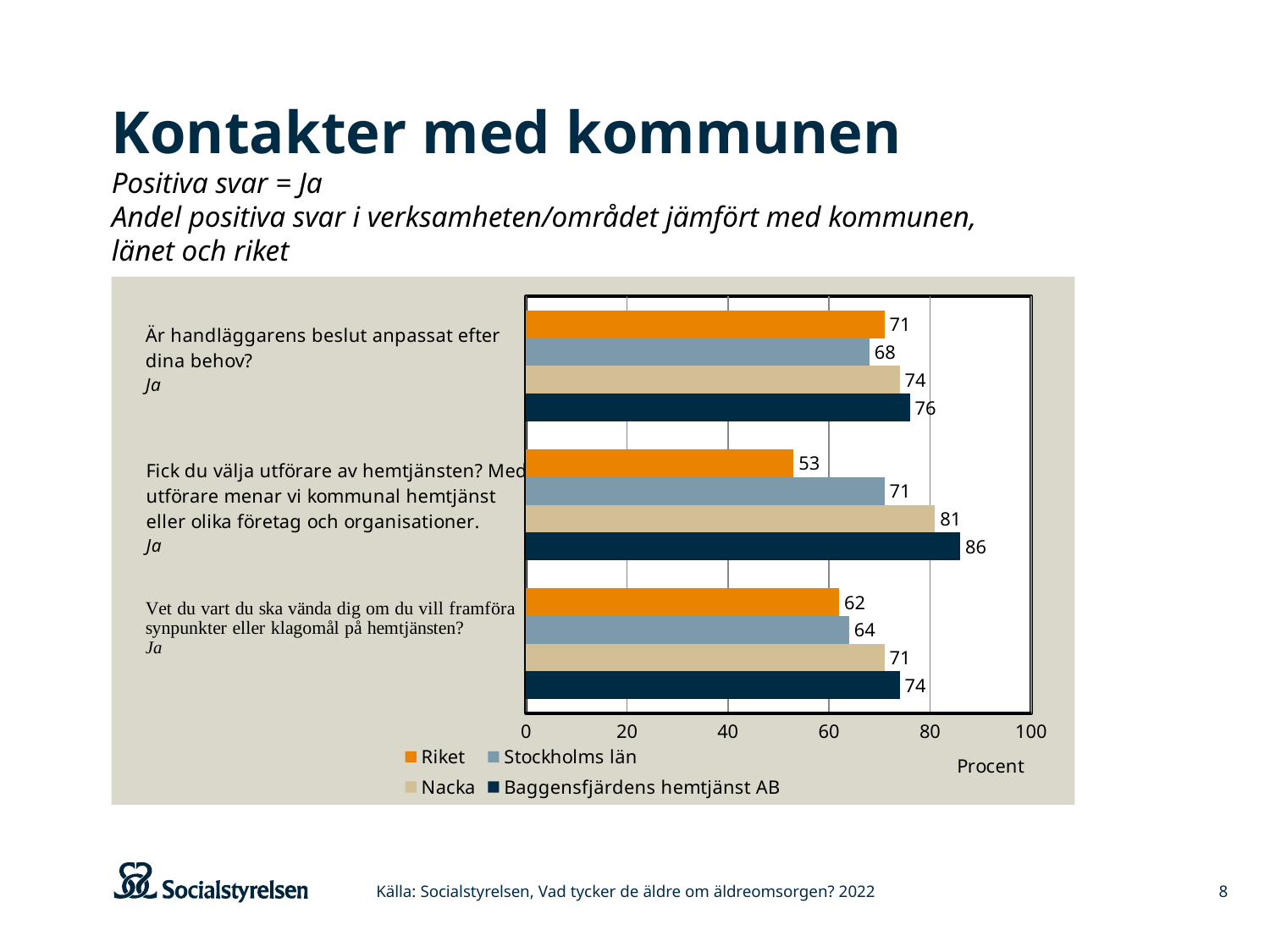
What is the label on the horizontal axis of the chart? Procent Which series has the highest value for the question "Vet du vart du ska vända dig om du vill framföra synpunkter eller klagomål på hemtjänsten?"? Baggensfjärdens hemtjänst AB Which series has the lowest value for the question "Fick du välja utförare av hemtjänsten?"? Riket What value does Nacka have for the question "Fick du välja utförare av hemtjänsten?"? 81 What value does Baggensfjärdens hemtjänst AB have for the question "Fick du välja utförare av hemtjänsten?"? 86 What is the difference between the Baggensfjärdens hemtjänst AB value and the Riket value for the question "Fick du välja utförare av hemtjänsten?"? 33 How many series does the legend list? 4 What kind of chart is shown on the slide? Bar chart For the question "Är handläggarens beslut anpassat efter dina behov?", which is larger: the value for Nacka or the value for Stockholms län? Nacka How many survey questions (categories) are shown on the chart? 3 What value does Riket have for the question "Är handläggarens beslut anpassat efter dina behov?"? 71 What value does Stockholms län have for the question "Vet du vart du ska vända dig om du vill framföra synpunkter eller klagomål på hemtjänsten?"? 64